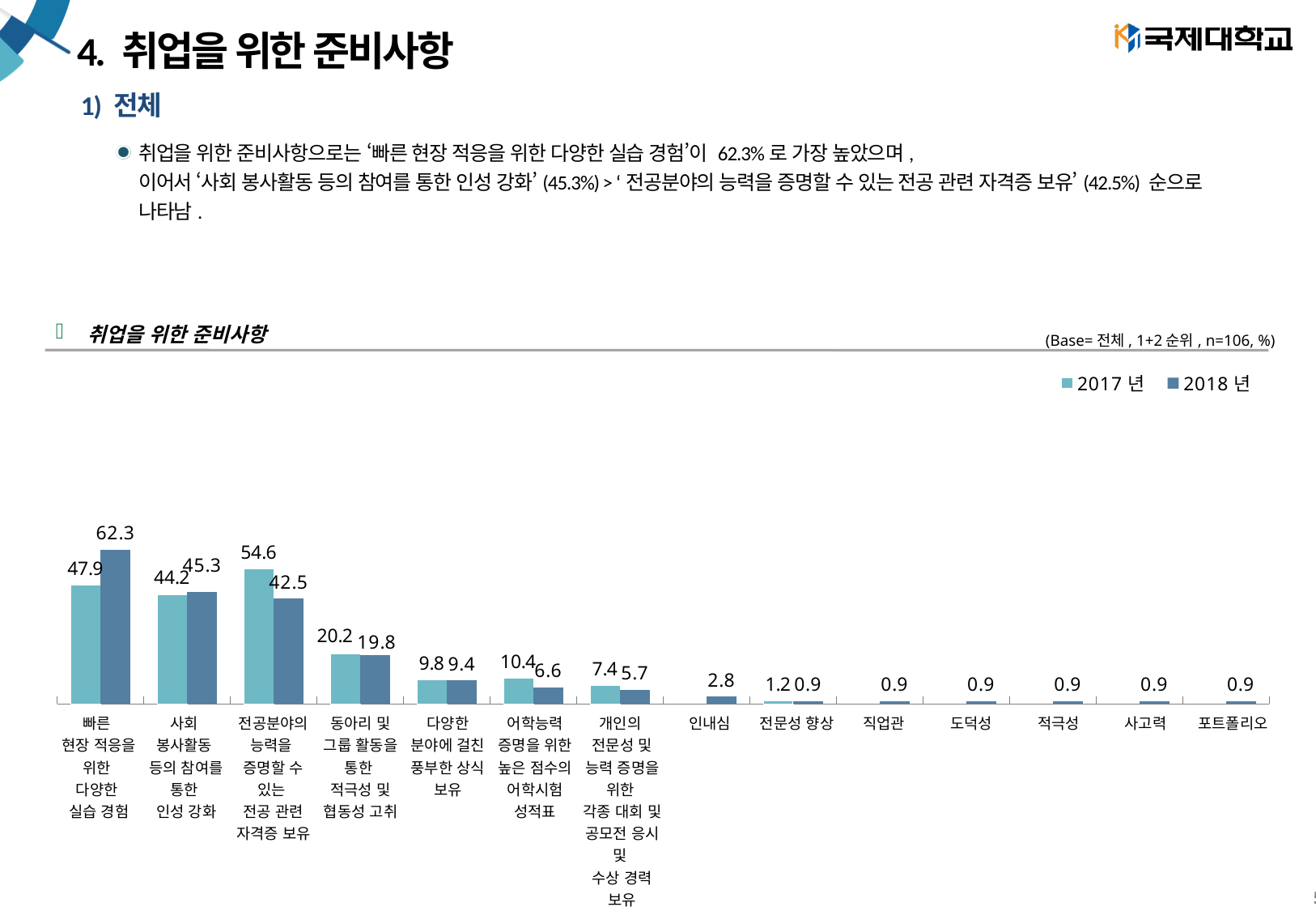
What is the 2018 년 value for '빠른 현장 적응을 위한 다양한 실습 경험'? 62.3 What is the 2018 년 value for '인내심'? 2.8 What kind of chart is shown on the slide? bar chart How many categories are shown on the x axis of the chart? 14 What is the 2017 년 value for '전공분야의 능력을 증명할 수 있는 전공 관련 자격증 보유'? 54.6 Which category has the highest 2018 년 value? 빠른 현장 적응을 위한 다양한 실습 경험 How many series does the chart legend list? 2 What is the difference between the 2018 년 and 2017 년 values for '빠른 현장 적응을 위한 다양한 실습 경험'? 14.4 What are the two series named in the chart legend? 2017 년, 2018 년 For '어학능력 증명을 위한 높은 점수의 어학시험 성적표', which year has the larger value, 2017 년 or 2018 년? 2017 년 Which category has the highest 2017 년 value? 전공분야의 능력을 증명할 수 있는 전공 관련 자격증 보유 What is the 2017 년 value for '전문성 향상'? 1.2